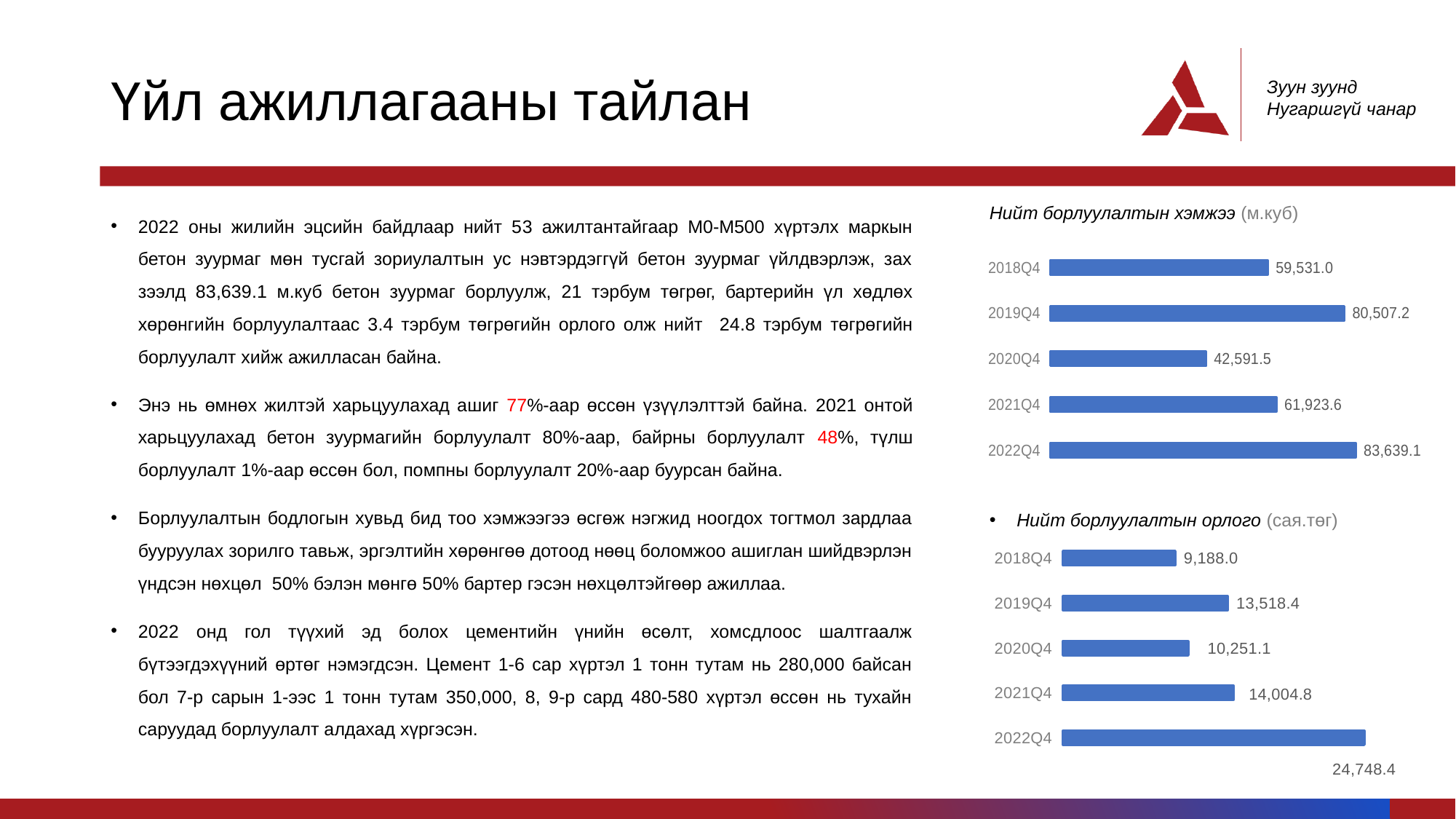
In the 'Нийт борлуулалтын орлого (сая.төг)' chart, what is the value for 2018Q4? 9,188.0 In the 'Нийт борлуулалтын хэмжээ (м.куб)' chart, what is the value for 2019Q4? 80,507.2 In the 'Нийт борлуулалтын орлого (сая.төг)' chart, what is the difference between the 2022Q4 and 2021Q4 values? 10,743.6 In the 'Нийт борлуулалтын хэмжээ (м.куб)' chart, how many periods are shown? 5 In the 'Нийт борлуулалтын хэмжээ (м.куб)' chart, which period has the lowest value? 2020Q4 In the 'Нийт борлуулалтын хэмжээ (м.куб)' chart, what is the value for 2022Q4? 83,639.1 In the 'Нийт борлуулалтын орлого (сая.төг)' chart, which period has the highest value? 2022Q4 In the 'Нийт борлуулалтын орлого (сая.төг)' chart, what is the value for 2021Q4? 14,004.8 What type of chart is the 'Нийт борлуулалтын орлого (сая.төг)' chart? Bar chart In the 'Нийт борлуулалтын хэмжээ (м.куб)' chart, what is the difference between the 2022Q4 and 2021Q4 values? 21,715.5 In the 'Нийт борлуулалтын хэмжээ (м.куб)' chart, which period has the highest value? 2022Q4 In the 'Нийт борлуулалтын орлого (сая.төг)' chart, which is larger, the value for 2019Q4 or 2020Q4? 2019Q4